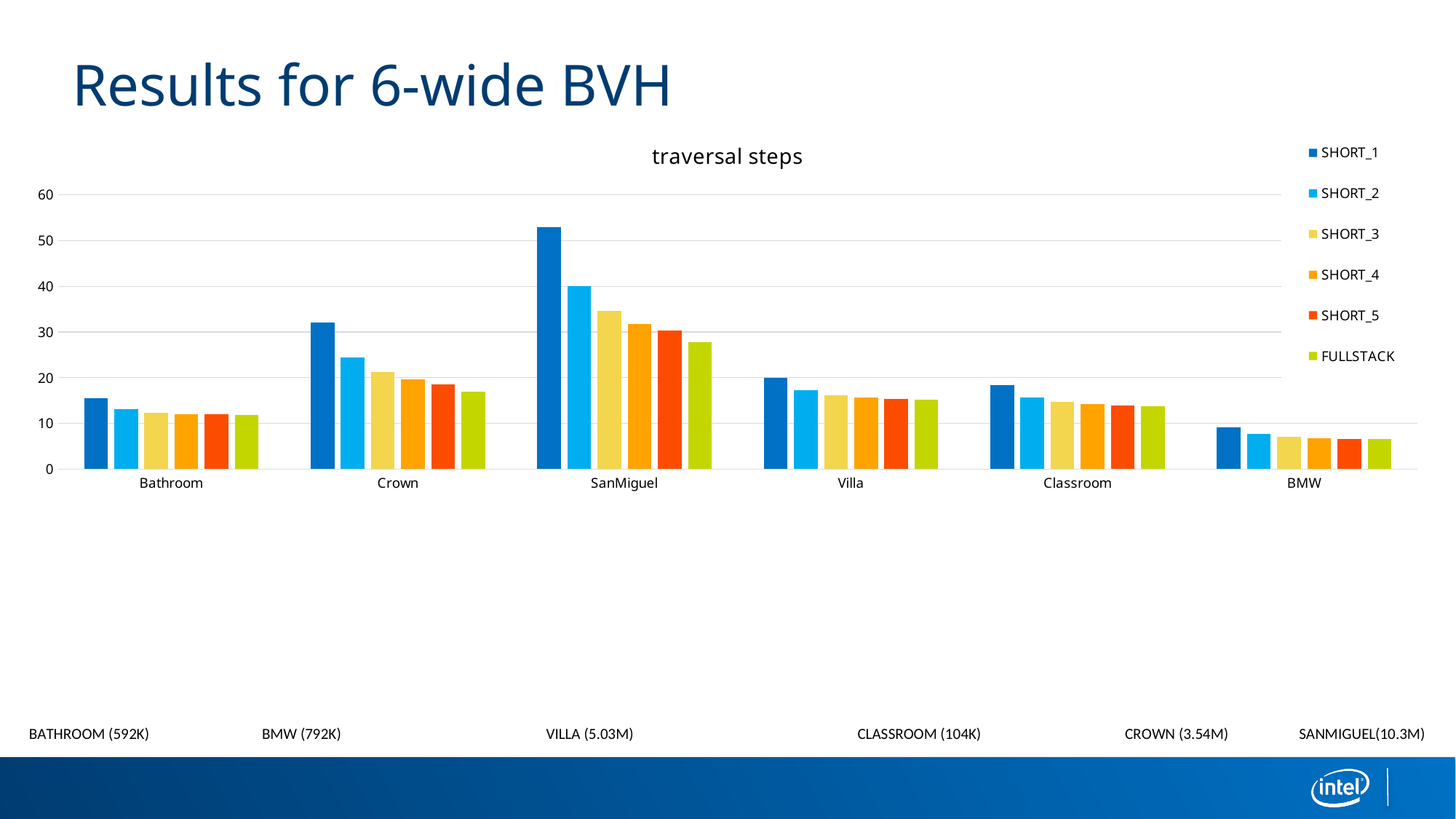
Which scene has the highest SHORT_1 value? SanMiguel Is the FULLSTACK value for BMW greater or less than 10? less Is the SHORT_2 value for Bathroom greater or less than 20? less What is the title of the chart? traversal steps For SanMiguel, do the values rise or fall going from SHORT_1 to FULLSTACK? fall Is the SHORT_1 value for Crown greater or less than 30? greater How many series does the chart legend list? 6 What kind of chart is shown on the slide? bar chart Which scene has the lowest SHORT_1 value? BMW Which has the larger SHORT_1 value, Crown or Villa? Crown How many scene categories are shown on the x axis of the chart? 6